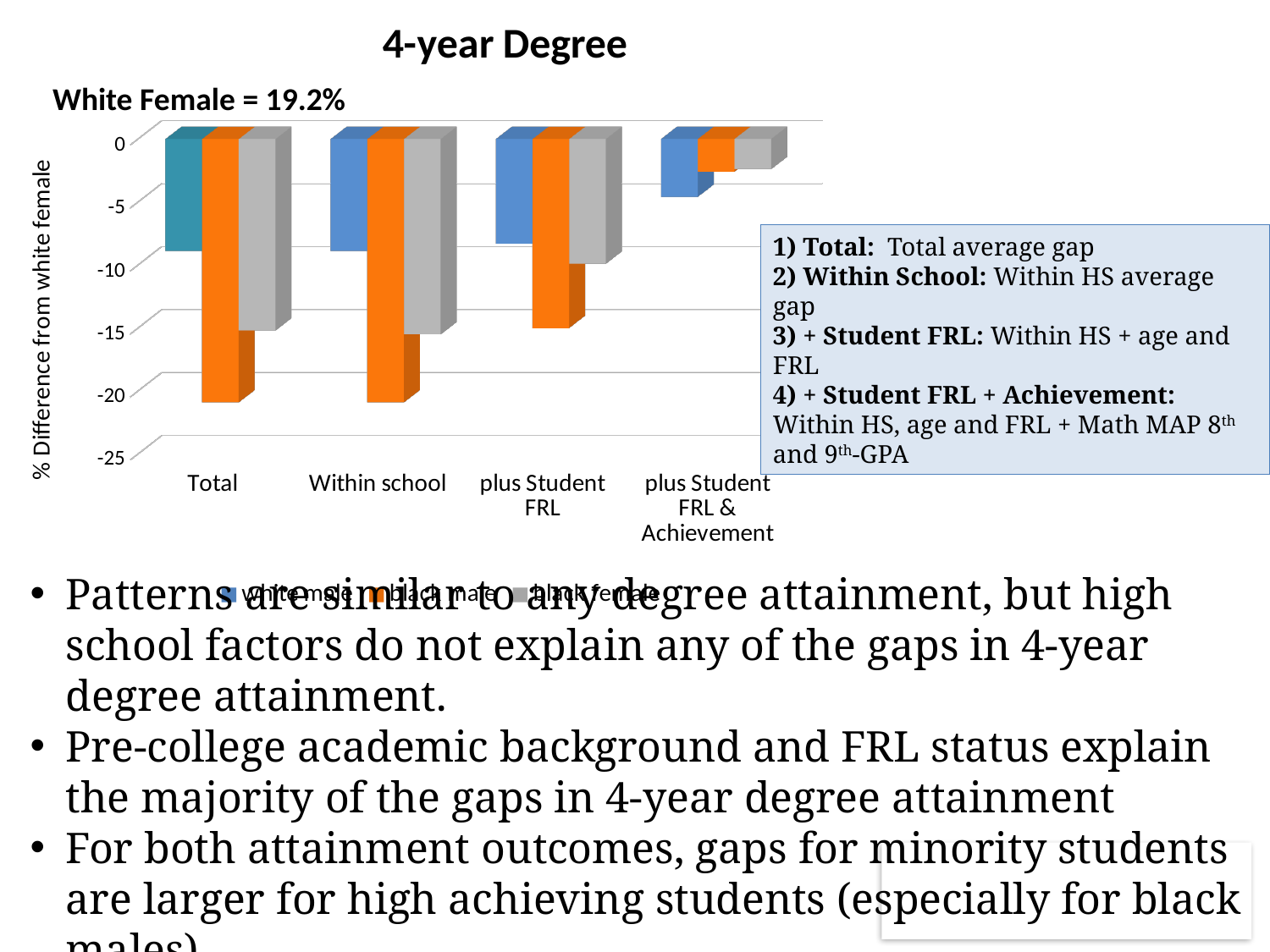
In which category are the bars for all three series closest to zero? plus Student FRL & Achievement Is the value for black male in the Total category greater or less than -15? less Moving from Total to plus Student FRL & Achievement, do the black male bars get closer to zero or further from zero? closer to zero Is the value for white male in the Total category greater or less than -15? greater What is the label of the vertical axis? % Difference from white female What is the title of the chart? 4-year Degree What kind of chart is shown on the slide? bar chart Is the value for black male in the plus Student FRL & Achievement category greater or less than -5? greater How many categories are shown along the x axis of the chart? 4 Which series has the most negative value in the Total category? black male How many series does the chart's legend list? 3 In the Within school category, which is more negative: the white male value or the black male value? black male